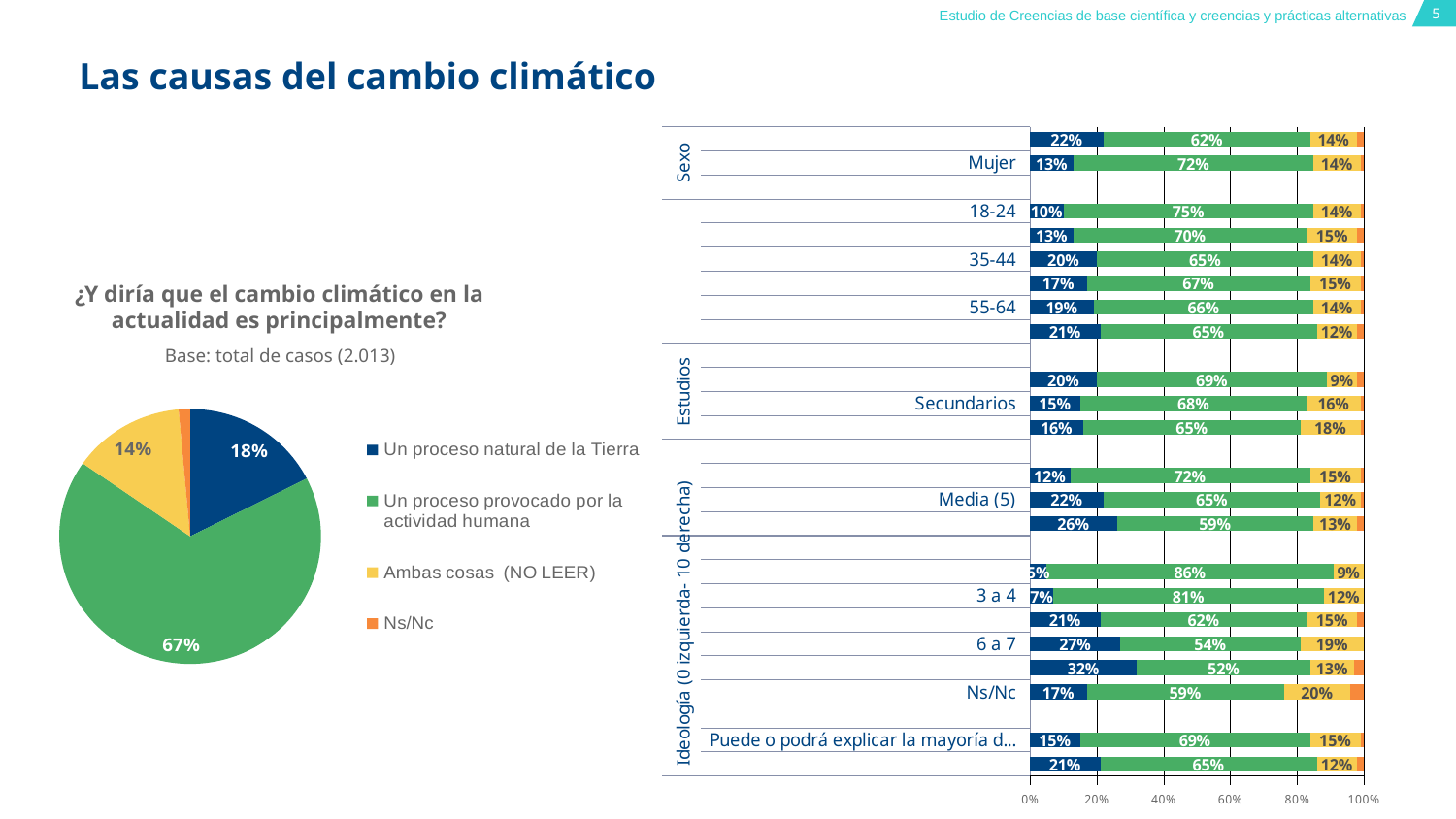
In the bar chart on the right, what is the blue (natural process) value for the '18-24' row? 10% What kind of chart is shown on the right side of the slide? Stacked bar chart In the bar chart on the right, what is the yellow value for the 'Ns/Nc' ideology row? 20% In the pie chart, what share of respondents said climate change is mainly 'Un proceso natural de la Tierra'? 18% How many entries does the legend of the pie chart list? 4 In the pie chart, what share of respondents said climate change is mainly 'Un proceso provocado por la actividad humana'? 67% In the pie chart, what is the difference between the share for 'Un proceso natural de la Tierra' and the share for 'Ambas cosas (NO LEER)'? 4 percentage points In the bar chart on the right, what is the green value for the '3 a 4' ideology row? 81% In the bar chart on the right, which is larger: the green value for '3 a 4' or the green value for '6 a 7'? 3 a 4 In the pie chart, which response has the largest slice? Un proceso provocado por la actividad humana In the bar chart on the right, what is the green (human activity) value for the 'Mujer' row? 72% In the bar chart on the right, what is the difference between the blue value for '6 a 7' and the blue value for '3 a 4'? 20 percentage points